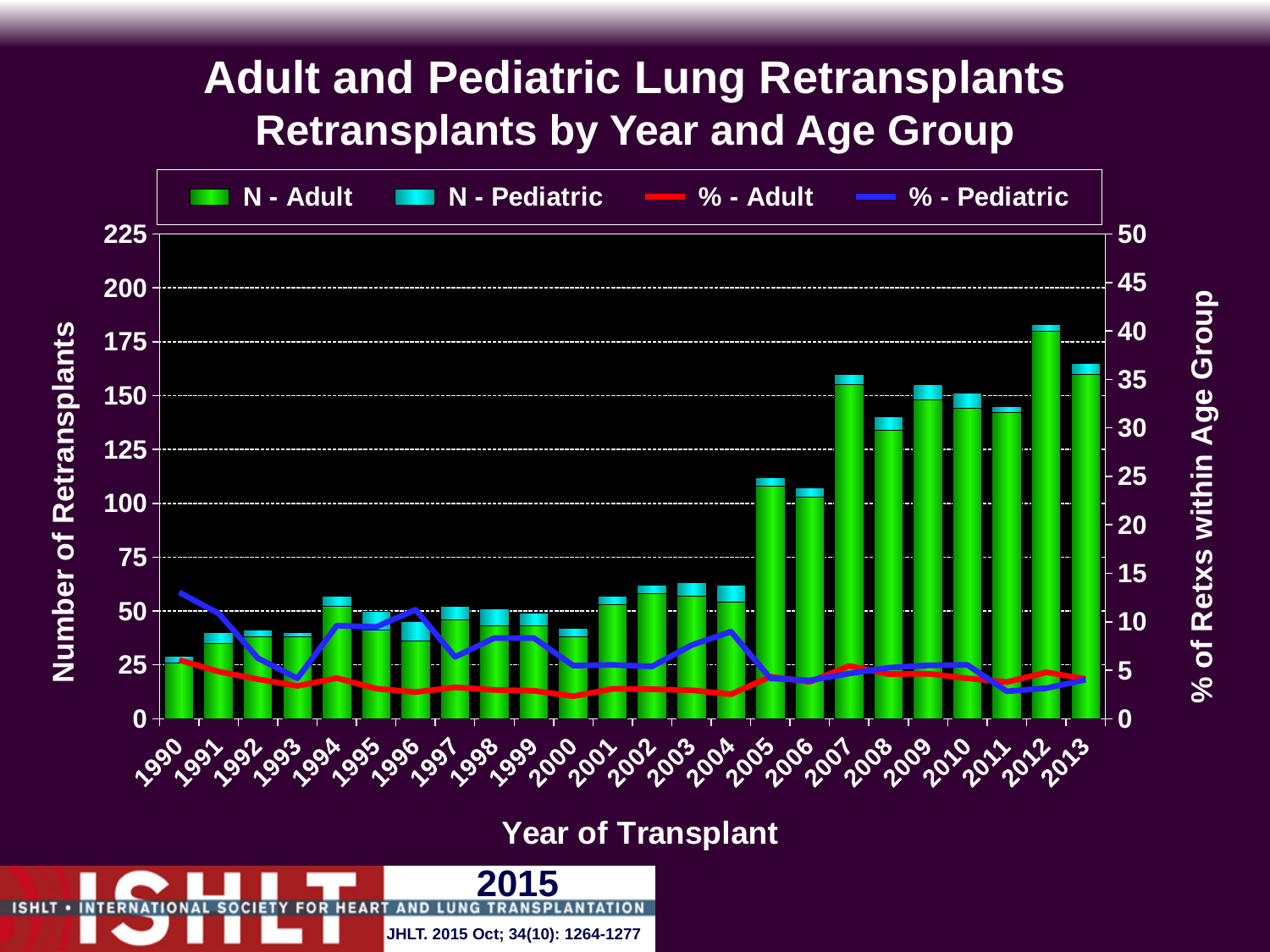
Which year has the tallest bar for number of retransplants? 2012 What kind of chart is shown on the slide? Bar chart with line series (combination chart) Is the total number of retransplants in 2012 greater or less than 150? greater Which year has the larger total number of retransplants, 2006 or 2007? 2007 Is the total number of retransplants in 1990 greater or less than 50? less How many years are shown along the x axis? 24 Is the total number of retransplants in 2005 greater or less than 100? greater Which year has the shortest bar for number of retransplants? 1990 Do the bars rise or fall from 2004 to 2005? rise What is the label of the left vertical axis? Number of Retransplants How many series does the legend list? 4